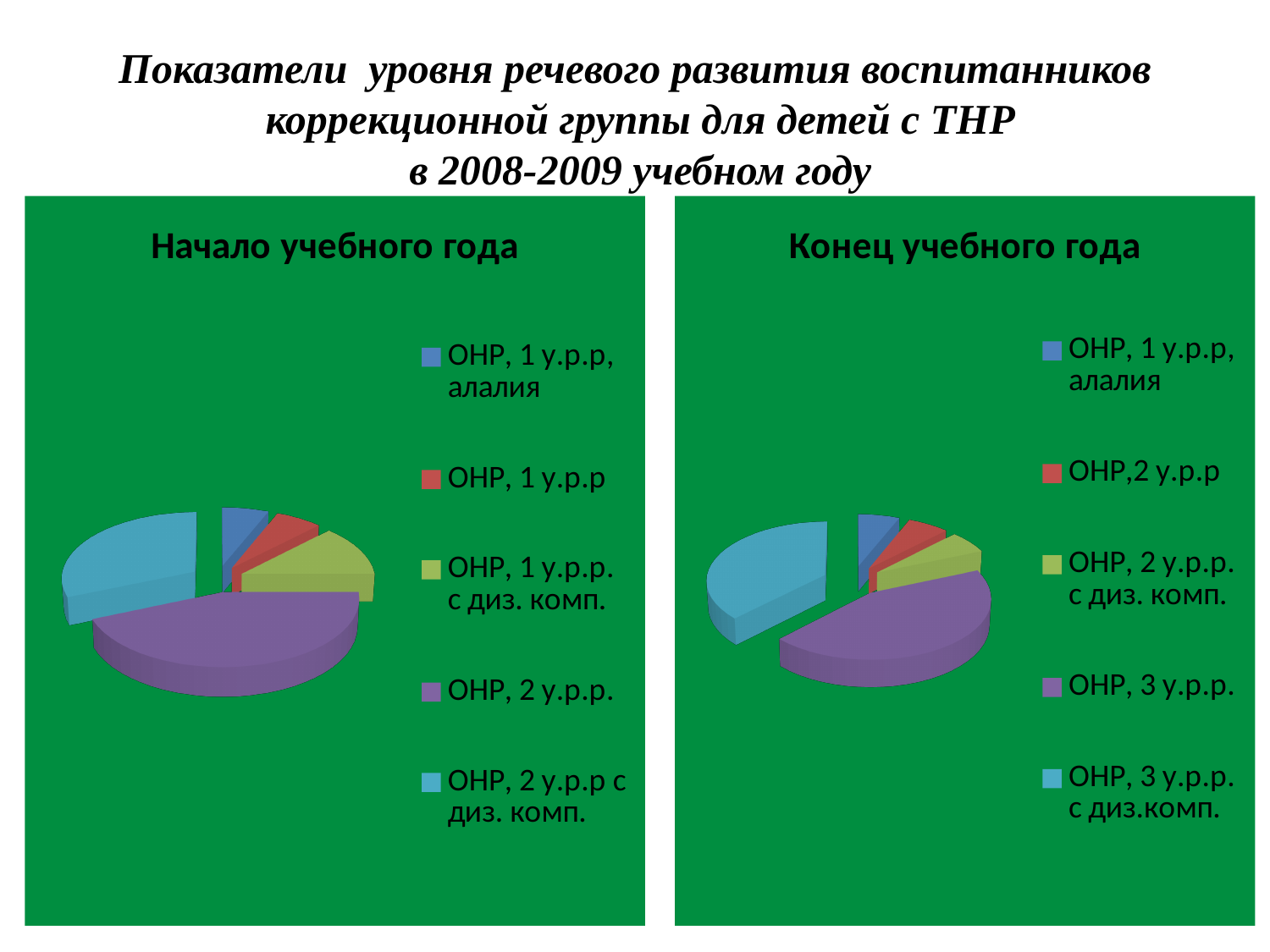
In the chart "Конец учебного года", what colour is the slice for "ОНР, 3 у.р.р."? purple In the chart "Начало учебного года", how many slices does the pie have? 5 In the chart "Конец учебного года", how many entries does the legend list? 5 In the chart "Начало учебного года", which slice is larger: "ОНР, 2 у.р.р." or "ОНР, 2 у.р.р с диз. комп."? ОНР, 2 у.р.р. In the chart "Начало учебного года", which category has the largest slice? ОНР, 2 у.р.р. In the chart "Начало учебного года", which slice is larger: "ОНР, 2 у.р.р с диз. комп." or "ОНР, 1 у.р.р. с диз. комп."? ОНР, 2 у.р.р с диз. комп. In the chart "Конец учебного года", which category has the largest slice? ОНР, 3 у.р.р. What is the title of the chart on the right side of the slide? Конец учебного года In the chart "Конец учебного года", which slice is larger: "ОНР, 3 у.р.р. с диз.комп." or "ОНР, 2 у.р.р. с диз. комп."? ОНР, 3 у.р.р. с диз.комп. What kind of chart is the right chart titled "Конец учебного года"? pie chart What kind of chart is the left chart titled "Начало учебного года"? pie chart